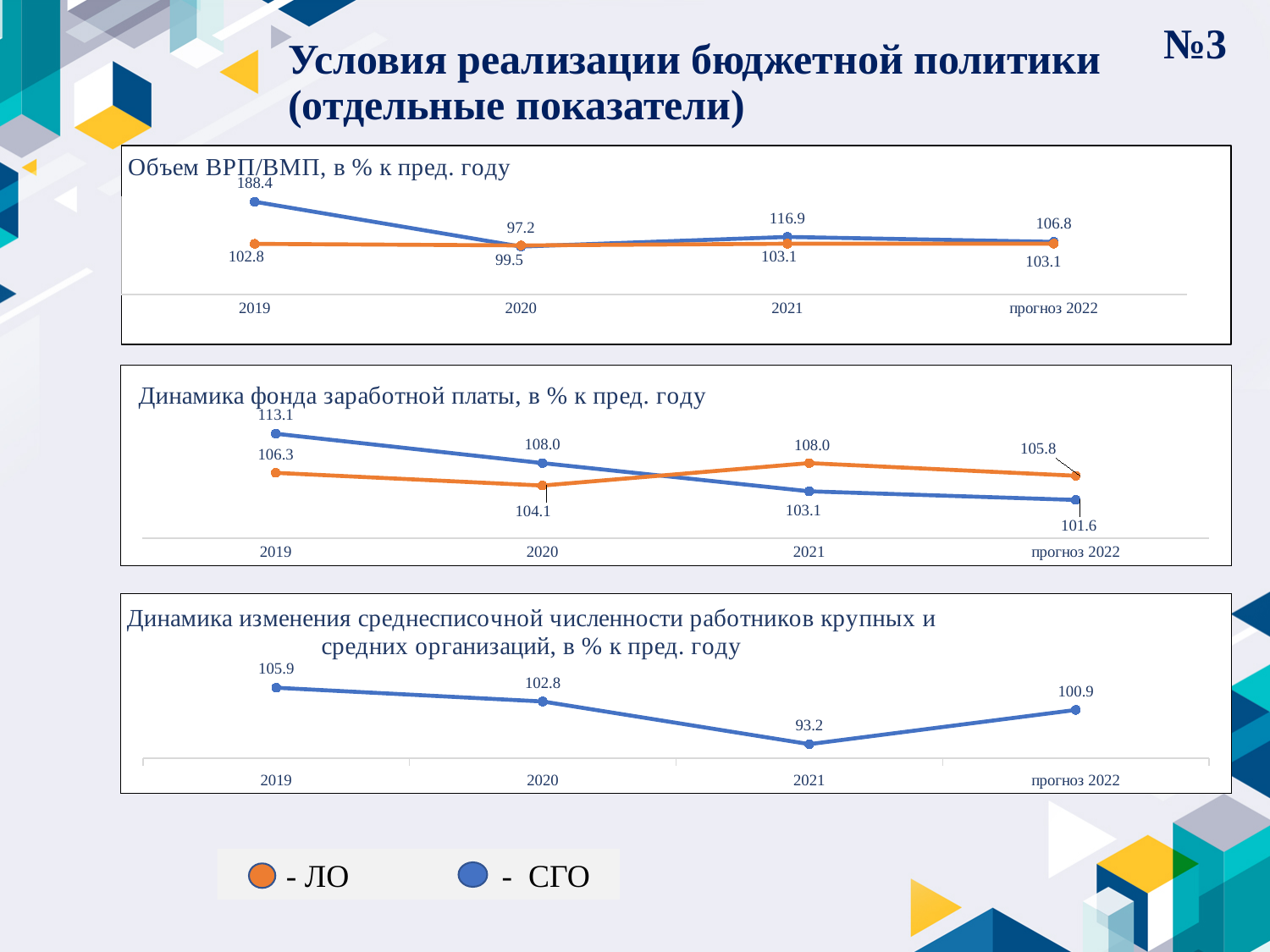
What type of chart is used for 'Объем ВРП/ВМП, в % к пред. году'? line chart In the chart 'Динамика фонда заработной платы, в % к пред. году', does the СГО (blue) line rise or fall from 2019 to прогноз 2022? fall In the chart 'Объем ВРП/ВМП, в % к пред. году', what is the difference between the СГО and ЛО values for 2021? 13.8 In the chart 'Объем ВРП/ВМП, в % к пред. году', what is the value of the ЛО (orange) line for 2020? 99.5 In the chart 'Динамика фонда заработной платы, в % к пред. году', in which year is the СГО (blue) line at its lowest? прогноз 2022 In the bottom chart on the slide (среднесписочная численность работников), what is the difference between the 2019 and 2020 values? 3.1 In the bottom chart on the slide (среднесписочная численность работников), which year has the lowest value? 2021 In the chart 'Динамика фонда заработной платы, в % к пред. году', which line has the larger value for 2021, ЛО or СГО? ЛО In the chart 'Объем ВРП/ВМП, в % к пред. году', in which year is the СГО (blue) line at its highest? 2019 In the bottom chart on the slide (среднесписочная численность работников), what is the value for 2021? 93.2 In the chart 'Объем ВРП/ВМП, в % к пред. году', what is the value of the СГО (blue) line for 2019? 188.4 In the chart 'Динамика фонда заработной платы, в % к пред. году', what is the value of the ЛО (orange) line for прогноз 2022? 105.8